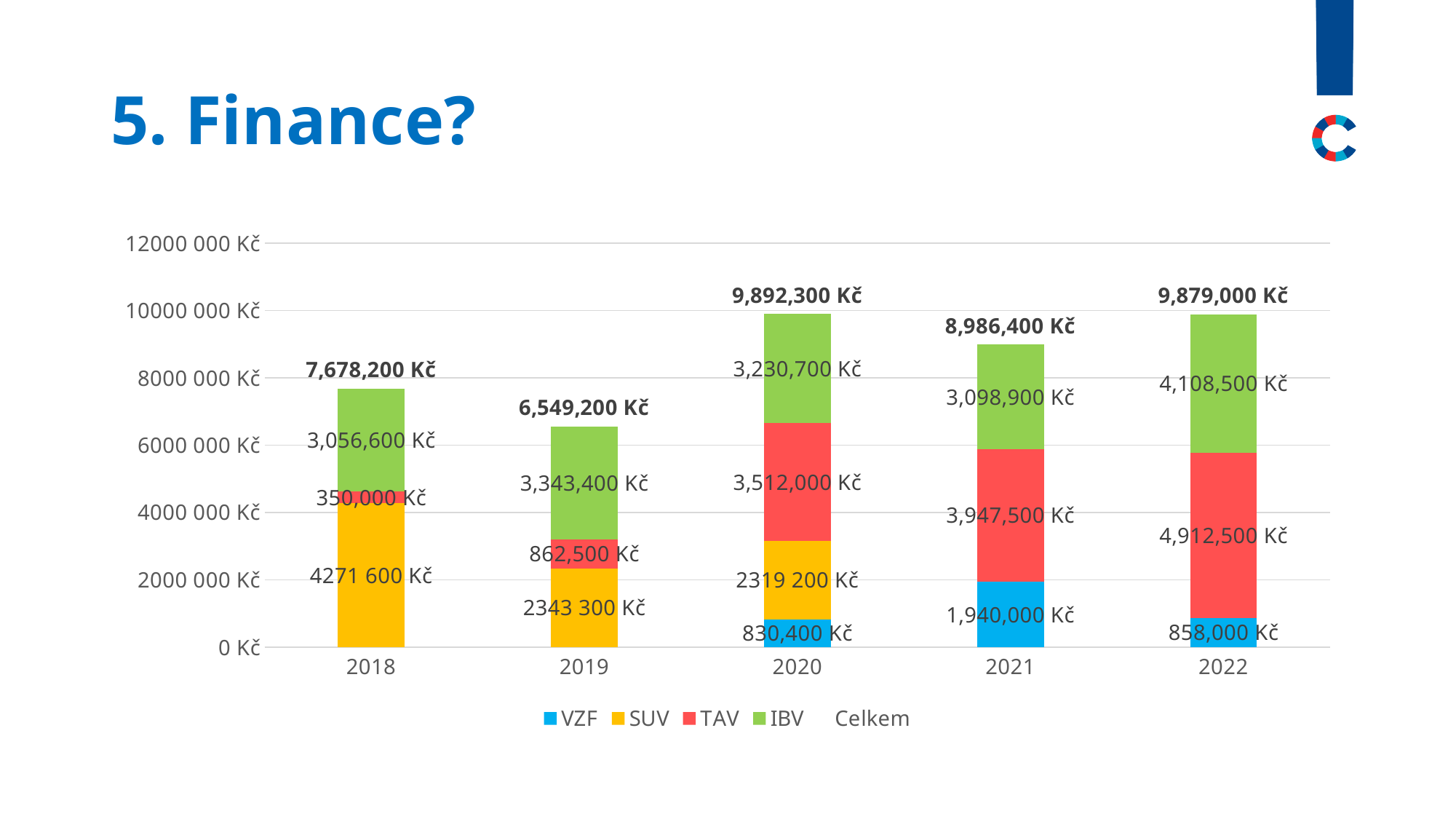
What kind of chart is shown on the slide? Stacked bar chart What is the VZF value for 2021? 1,940,000 Kč Which year has the highest total (Celkem) value? 2020 What is the difference between the TAV values for 2022 and 2021? 965,000 Kč Which year has the lowest total (Celkem) value? 2019 Which is larger, the IBV value for 2019 or the IBV value for 2021? 2019 What is the total (Celkem) value for 2020? 9,892,300 Kč What is the total of the stacked bar for 2018? 7,678,200 Kč How many years are shown on the x axis? 5 What is the TAV value for 2019? 862,500 Kč How many series does the legend list? 5 What is the IBV value for 2022? 4,108,500 Kč